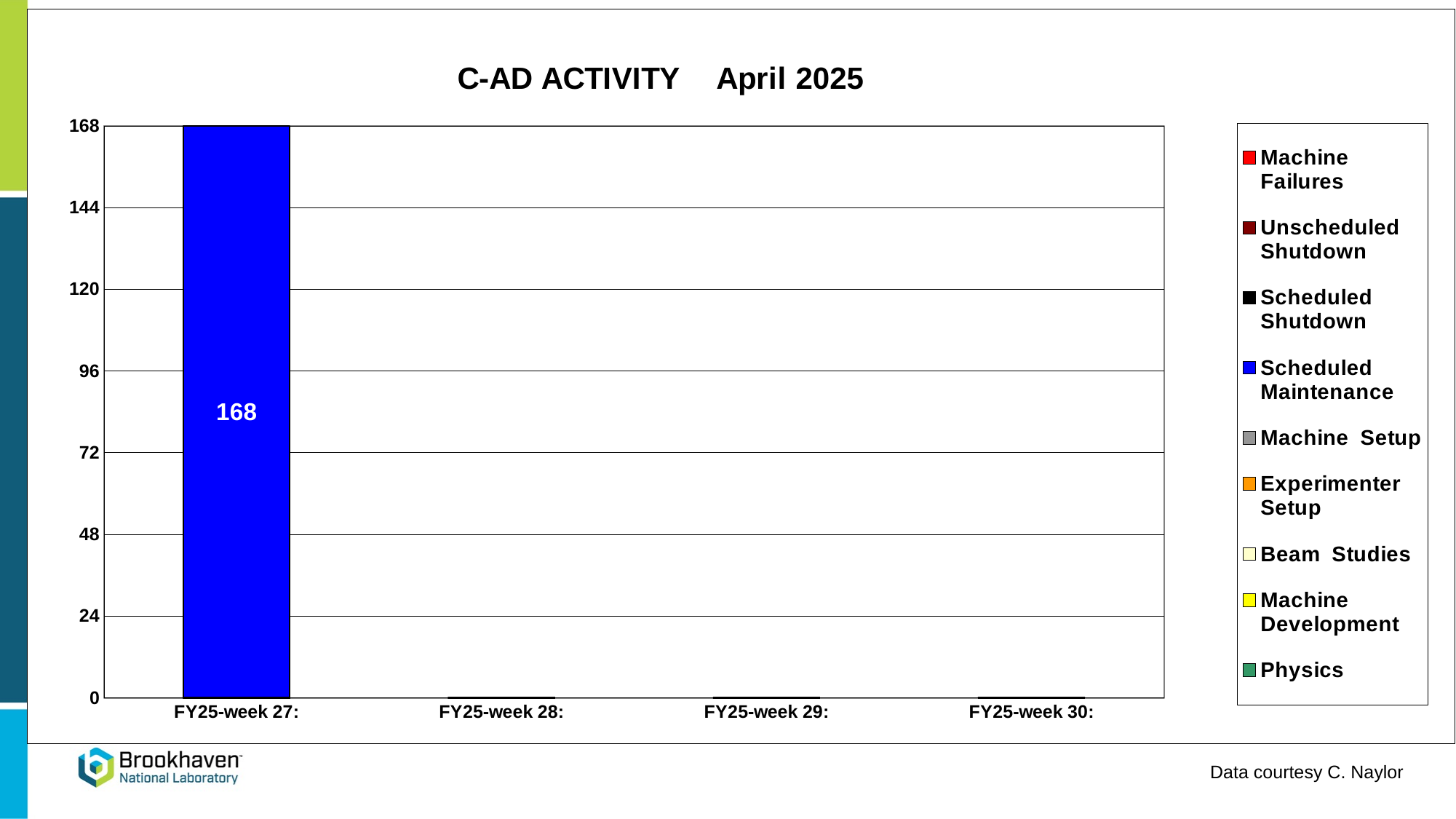
Do the plotted values rise or fall from FY25-week 27 to FY25-week 30? fall Which series does the only visible bar belong to? Scheduled Maintenance What is the title of the chart? C-AD ACTIVITY April 2025 What kind of chart is shown on the slide? bar chart Which week category has the highest plotted value? FY25-week 27: Is the value for FY25-week 27 greater or less than 144? greater What is the maximum value shown on the y axis? 168 What is the value of the Scheduled Maintenance bar for FY25-week 27? 168 Which is larger, the value for FY25-week 27 or the value for FY25-week 28? FY25-week 27: How many week categories are shown on the x axis? 4 How many series does the legend list? 9